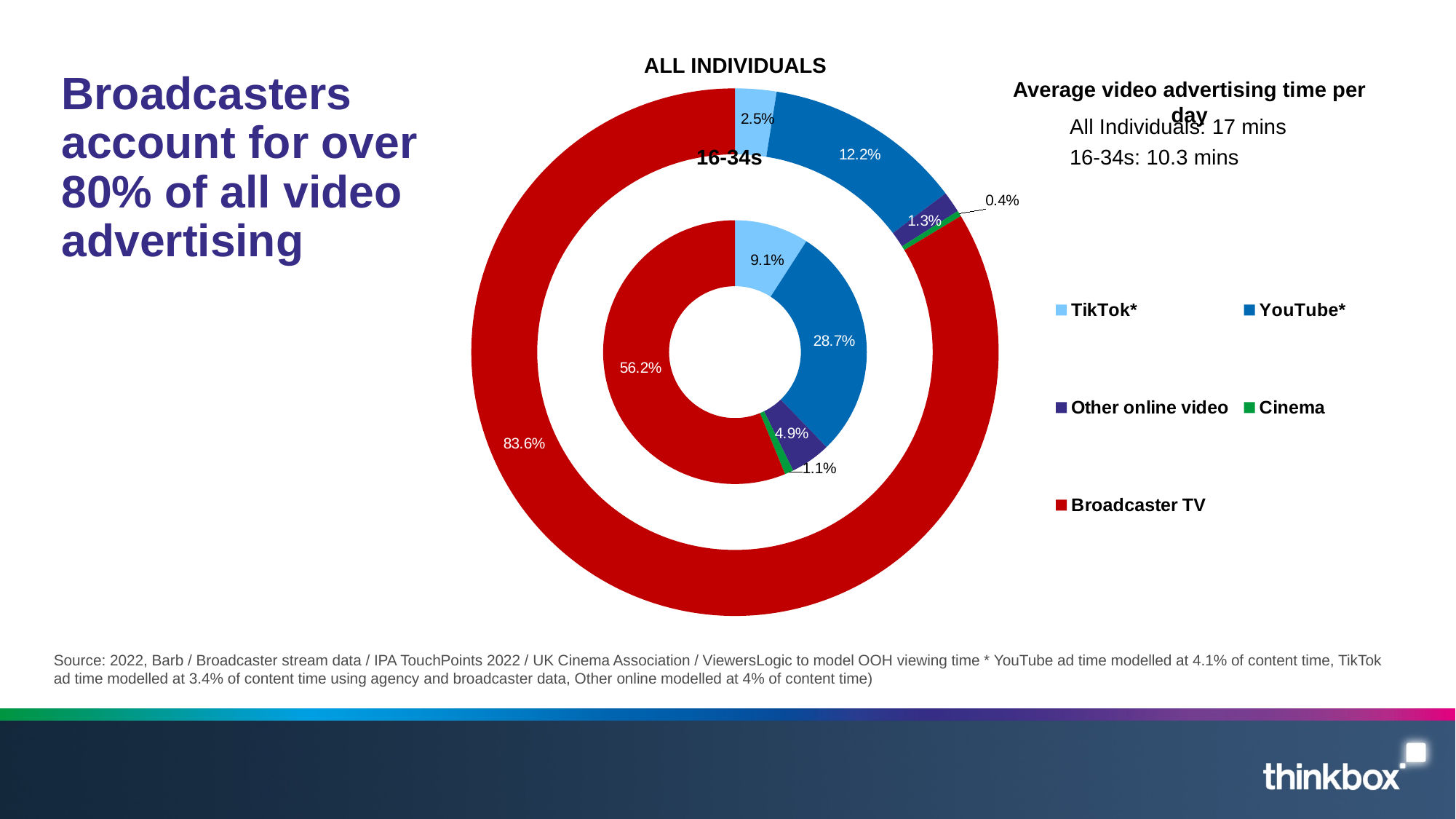
Which colour represents Broadcaster TV in the chart? Red In the ALL INDIVIDUALS ring, what share does Broadcaster TV account for? 83.6% In the 16-34s ring, what share does Other online video account for? 4.9% Which category has the smallest share in the 16-34s ring? Cinema How many series does the legend list? 5 In the 16-34s ring, what share does TikTok* account for? 9.1% What is the difference between the Broadcaster TV share for ALL INDIVIDUALS and for 16-34s? 27.4% In the 16-34s ring, what share does YouTube* account for? 28.7% Which category has the largest share in the ALL INDIVIDUALS ring? Broadcaster TV In the ALL INDIVIDUALS ring, what share does Cinema account for? 0.4% Is the YouTube* share larger for ALL INDIVIDUALS or for 16-34s? 16-34s What kind of chart is shown on the slide? Doughnut chart